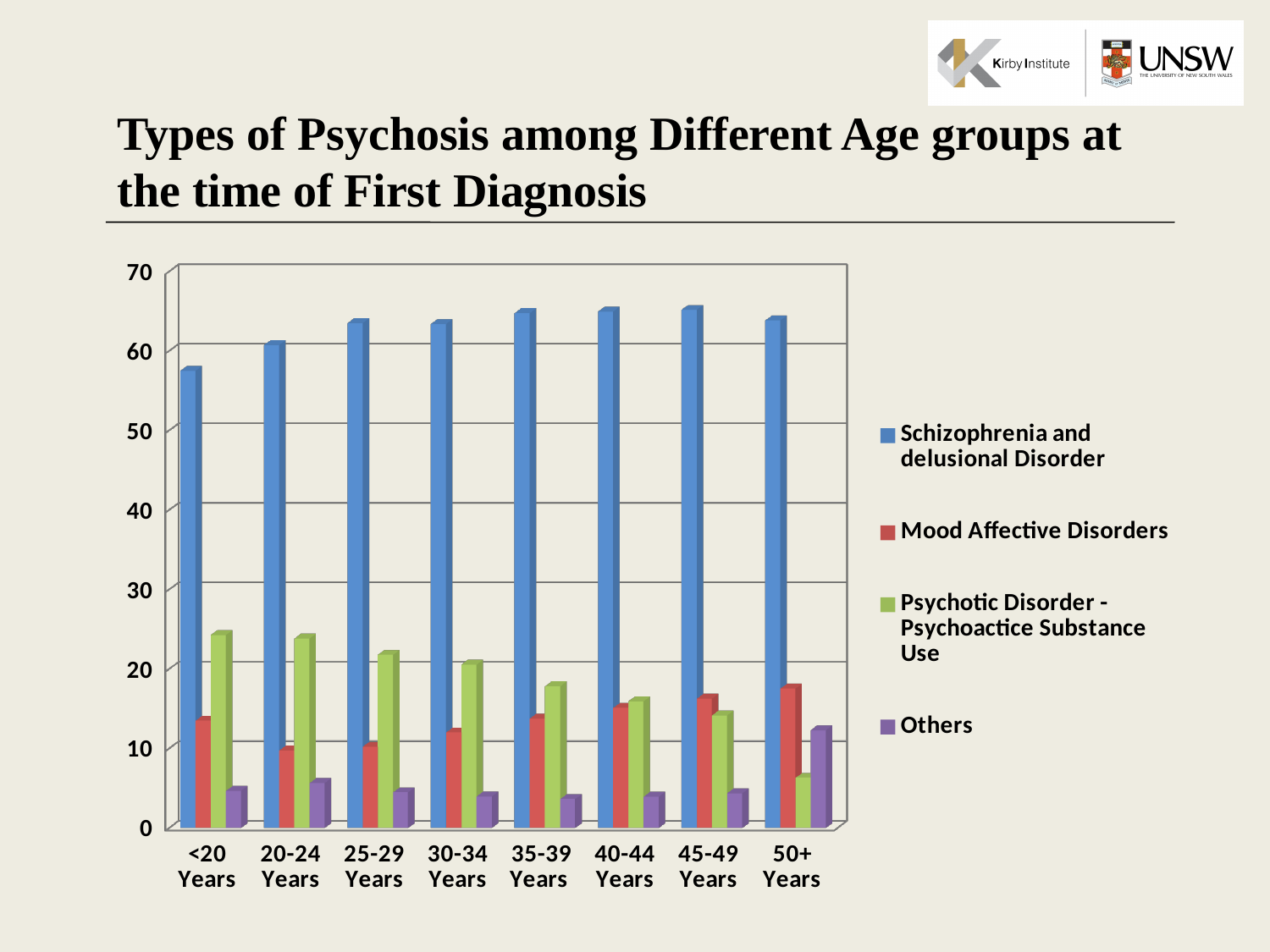
Does the value for Psychotic Disorder - Psychoactice Substance Use rise or fall as age group increases from <20 Years to 50+ Years? Fall In the 50+ Years group, which is larger: Mood Affective Disorders or Psychotic Disorder - Psychoactice Substance Use? Mood Affective Disorders Which age group has the lowest value for Psychotic Disorder - Psychoactice Substance Use? 50+ Years Is the value for Others in the 50+ Years group greater or less than 10? greater Which age group has the highest value for Others? 50+ Years Is the value for Schizophrenia and delusional Disorder in the 45-49 Years group greater or less than 60? greater Which age group has the lowest value for Schizophrenia and delusional Disorder? <20 Years How many age groups are shown on the x axis? 8 Is the value for Schizophrenia and delusional Disorder in the <20 Years group greater or less than 50? greater What kind of chart is shown on the slide? Bar chart How many series does the legend list? 4